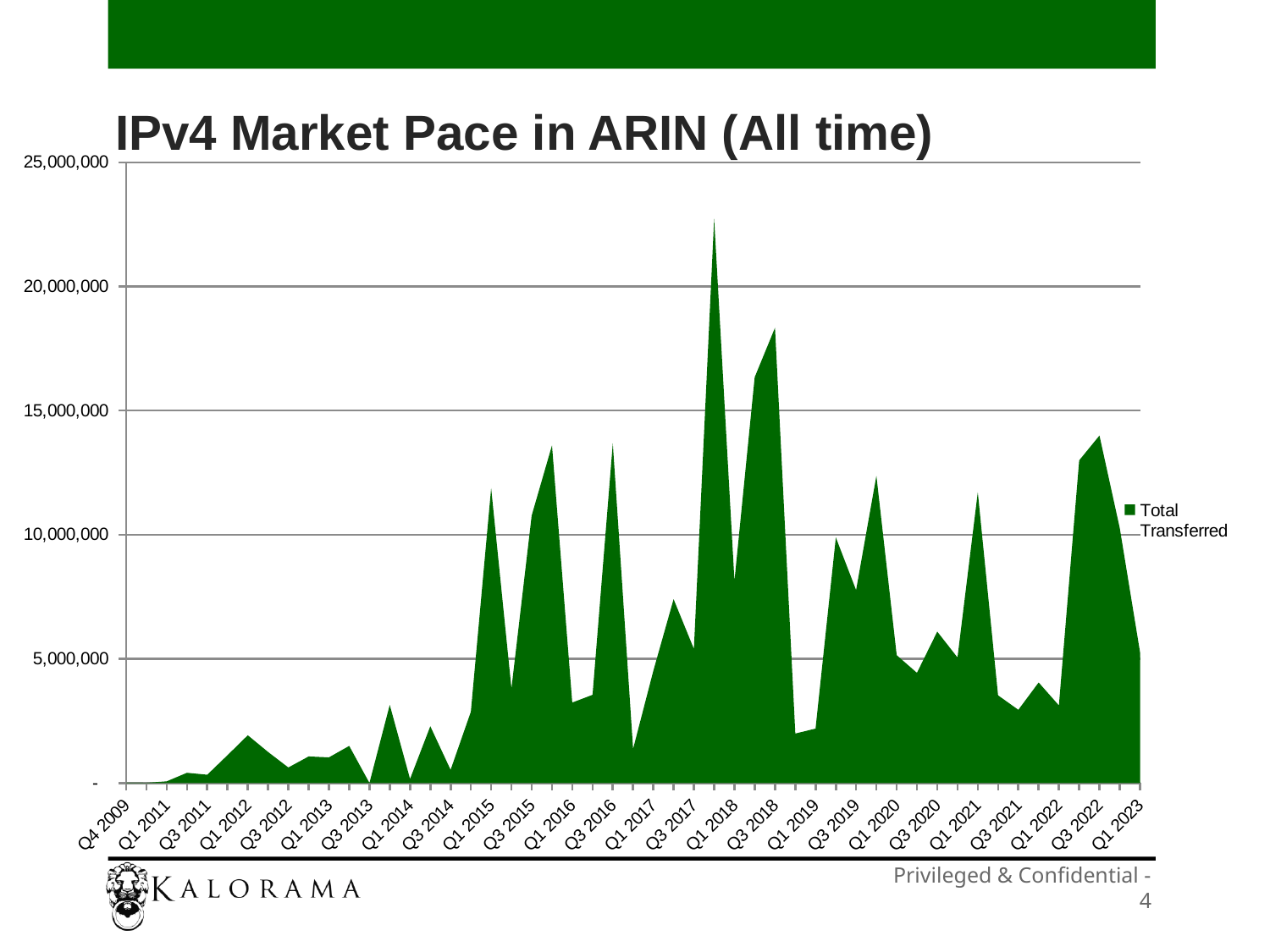
What kind of chart is shown on the slide? area chart Is the value for Q3 2022 greater or less than 10,000,000? greater At which quarter does Total Transferred reach its highest peak? Q4 2017 How many series does the legend list? 1 Which is larger, the value for Q1 2018 or the value for Q3 2018? Q3 2018 What is the highest value shown on the vertical axis? 25,000,000 What is the name of the series shown in the legend? Total Transferred Is the value for Q4 2009 greater or less than 5,000,000? less Is the value for Q3 2018 greater or less than 15,000,000? greater Do the values generally rise or fall from Q4 2009 to Q1 2018? rise